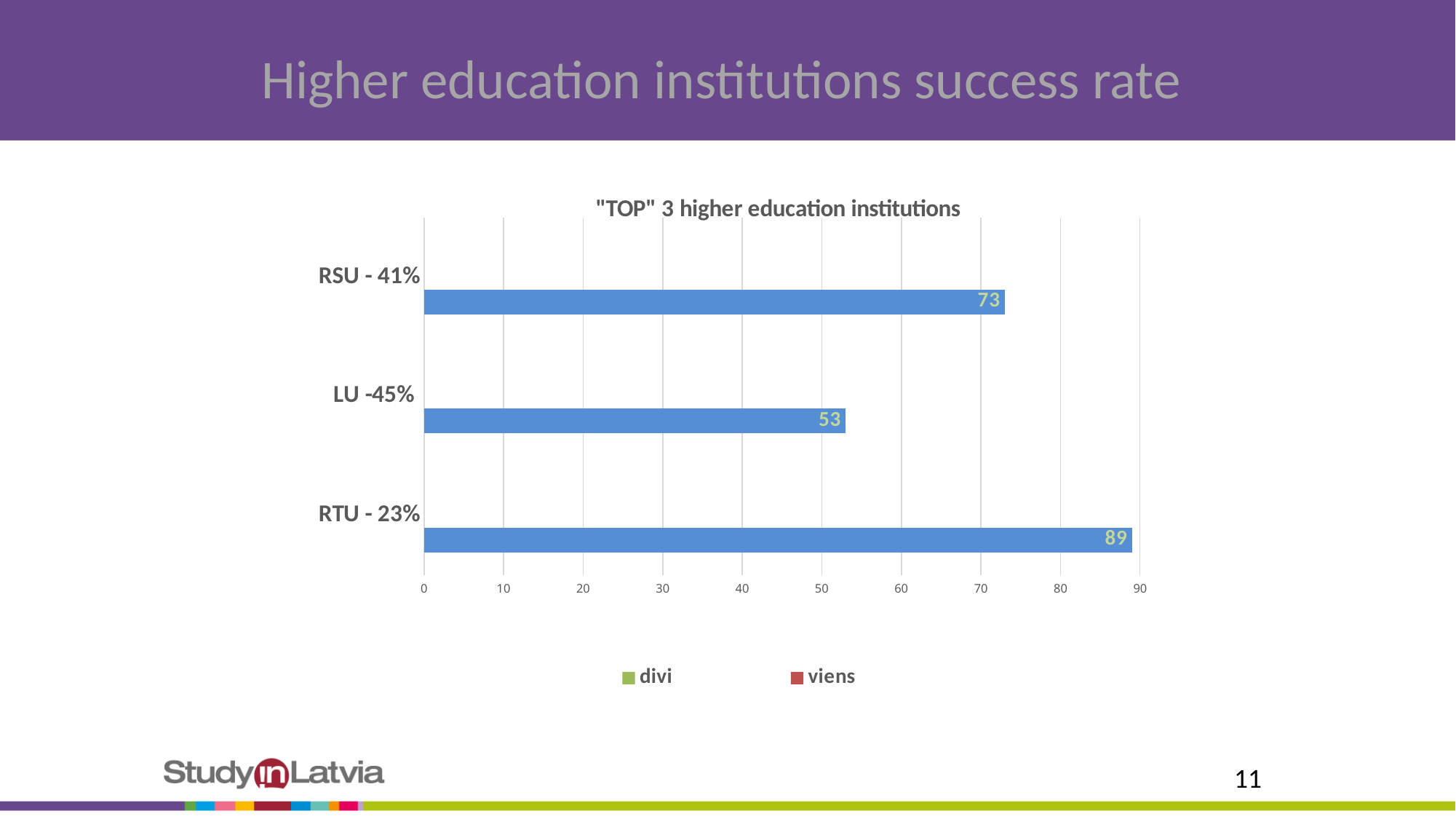
Which is larger, the value for RSU - 41% or the value for LU -45%? RSU - 41% What is the value for LU -45%? 53 Which category has the lowest value? LU -45% How many categories are shown in the chart? 3 Is the value for LU -45% greater or less than 60? less What is the title of the chart? "TOP" 3 higher education institutions What is the value for RTU - 23%? 89 What kind of chart is shown on the slide? bar chart Which category has the highest value? RTU - 23% What is the value for RSU - 41%? 73 What is the difference between the values for RTU - 23% and LU -45%? 36 What is the difference between the values for RTU - 23% and RSU - 41%? 16